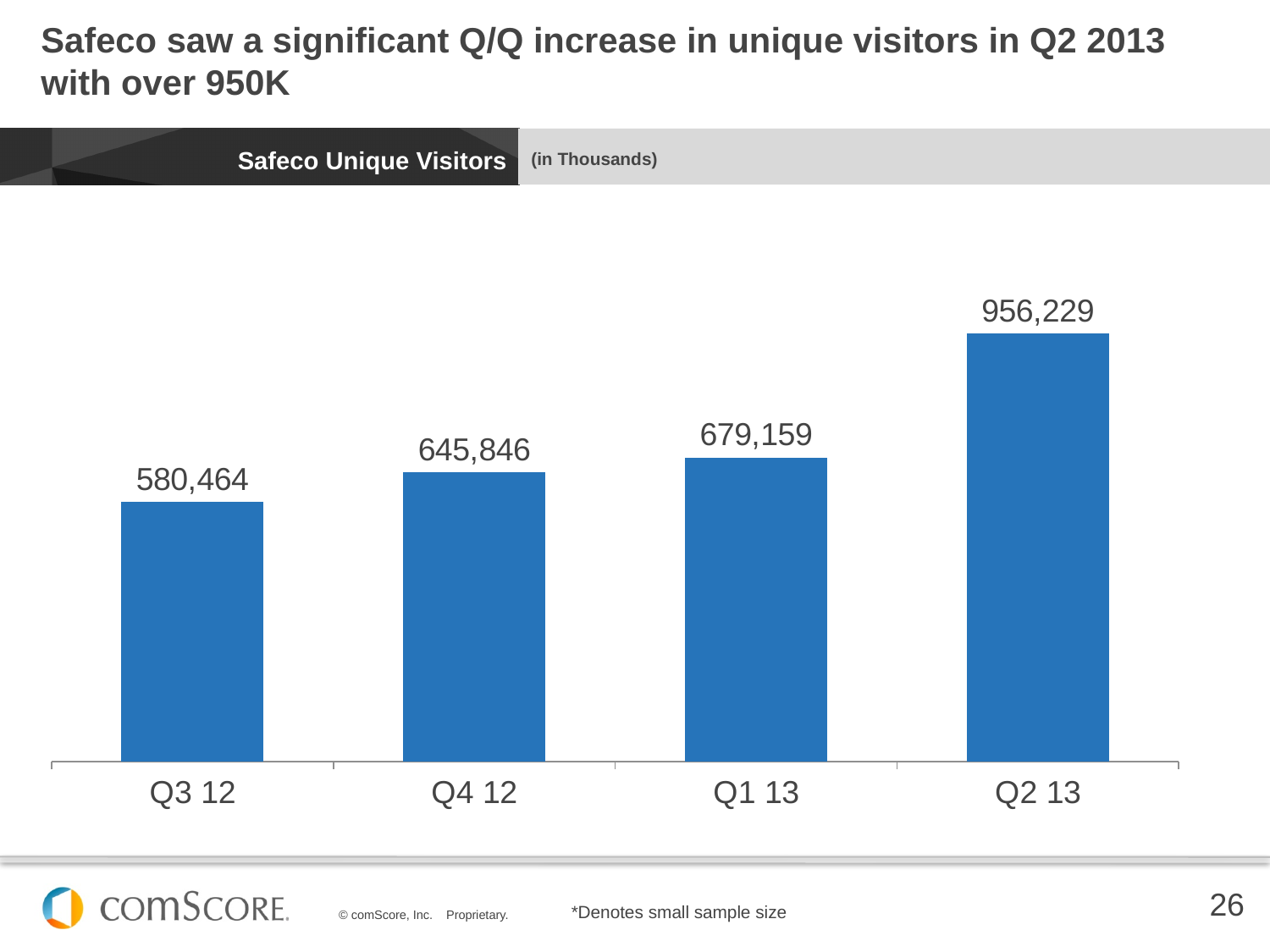
Which quarter has the lowest number of unique visitors? Q3 12 How many quarters are shown on the chart? 4 Do the values rise or fall from Q3 12 to Q2 13? Rise Which quarter has the highest number of unique visitors? Q2 13 What is the value for Q4 12? 645,846 Which is larger, the value for Q1 13 or the value for Q4 12? Q1 13 What kind of chart is shown on the slide? Bar chart What is the value for Q1 13? 679,159 What is the difference between the values for Q4 12 and Q3 12? 65,382 What is the value for Q3 12? 580,464 What is the difference between the values for Q2 13 and Q1 13? 277,070 What is the value for Q2 13? 956,229